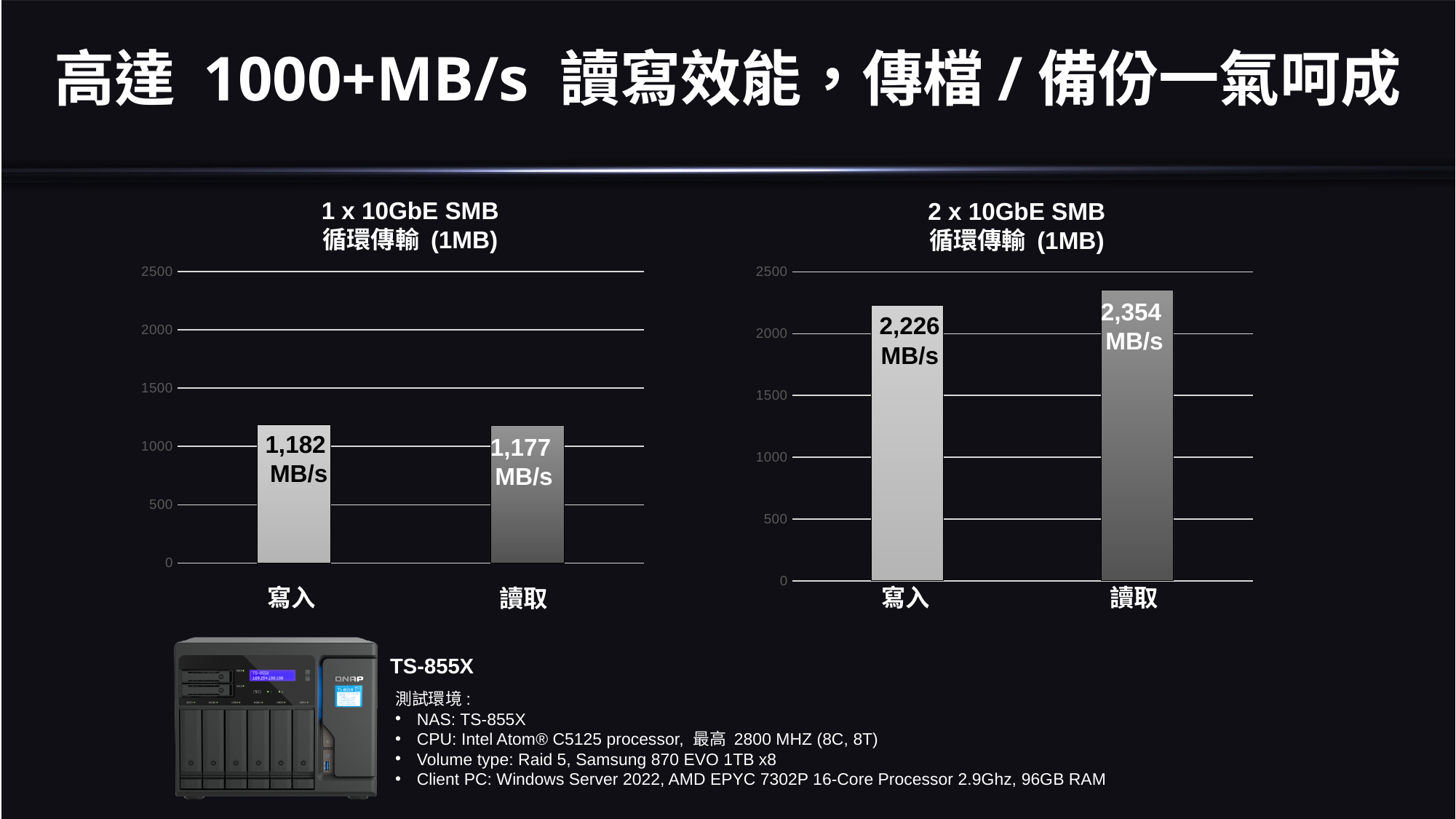
In the left chart (1 x 10GbE SMB 循環傳輸 (1MB)), what is the value for 寫入? 1,182 MB/s In the right chart (2 x 10GbE SMB 循環傳輸 (1MB)), what is the value for 寫入? 2,226 MB/s In the right chart (2 x 10GbE SMB 循環傳輸 (1MB)), is the value for 寫入 greater or less than 2000? greater What kind of chart is the right chart (2 x 10GbE SMB 循環傳輸 (1MB))? bar chart In the right chart (2 x 10GbE SMB 循環傳輸 (1MB)), which category has the highest value? 讀取 In the left chart (1 x 10GbE SMB 循環傳輸 (1MB)), is the value for 寫入 greater or less than 1000? greater In the left chart (1 x 10GbE SMB 循環傳輸 (1MB)), what is the value for 讀取? 1,177 MB/s In the left chart (1 x 10GbE SMB 循環傳輸 (1MB)), what is the difference between 寫入 and 讀取? 5 MB/s In the right chart (2 x 10GbE SMB 循環傳輸 (1MB)), what is the difference between 讀取 and 寫入? 128 MB/s How many categories does the left chart (1 x 10GbE SMB 循環傳輸 (1MB)) show? 2 In the right chart (2 x 10GbE SMB 循環傳輸 (1MB)), what is the value for 讀取? 2,354 MB/s In the right chart (2 x 10GbE SMB 循環傳輸 (1MB)), which is larger, 寫入 or 讀取? 讀取